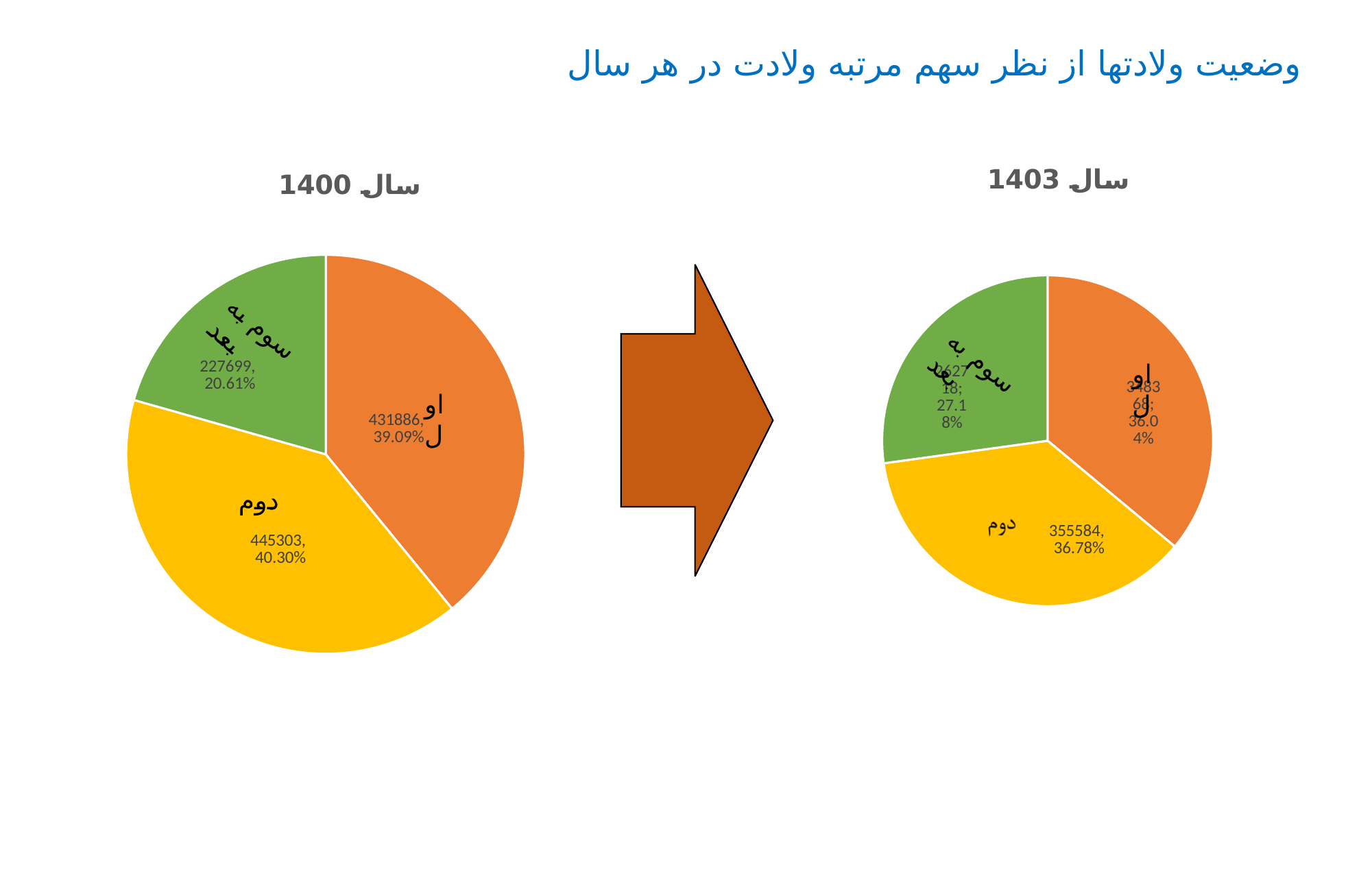
In the 'سال 1400' pie chart, what value and share are shown for the 'دوم' slice? 445303, 40.30% What type of chart is used for 'سال 1403'? Pie chart In the 'سال 1400' pie chart, what share is shown for the 'اول' slice? 39.09% Which is larger: the 'دوم' value in the 'سال 1400' chart or the 'دوم' value in the 'سال 1403' chart? سال 1400 In the 'سال 1400' pie chart, which slice has the largest share? دوم How many slices does the 'سال 1400' pie chart have? 3 In the 'سال 1400' pie chart, which slice has the smallest share? سوم به بعد What colour is the 'دوم' slice in both pie charts? Yellow In the 'سال 1400' pie chart, what is the difference between the 'دوم' value and the 'اول' value? 13417 In the 'سال 1403' pie chart, what value and share are shown for the 'دوم' slice? 355584, 36.78% In the 'سال 1400' pie chart, what value is shown for the 'سوم به بعد' slice? 227699 In the 'سال 1403' pie chart, which slice is the smallest? سوم به بعد